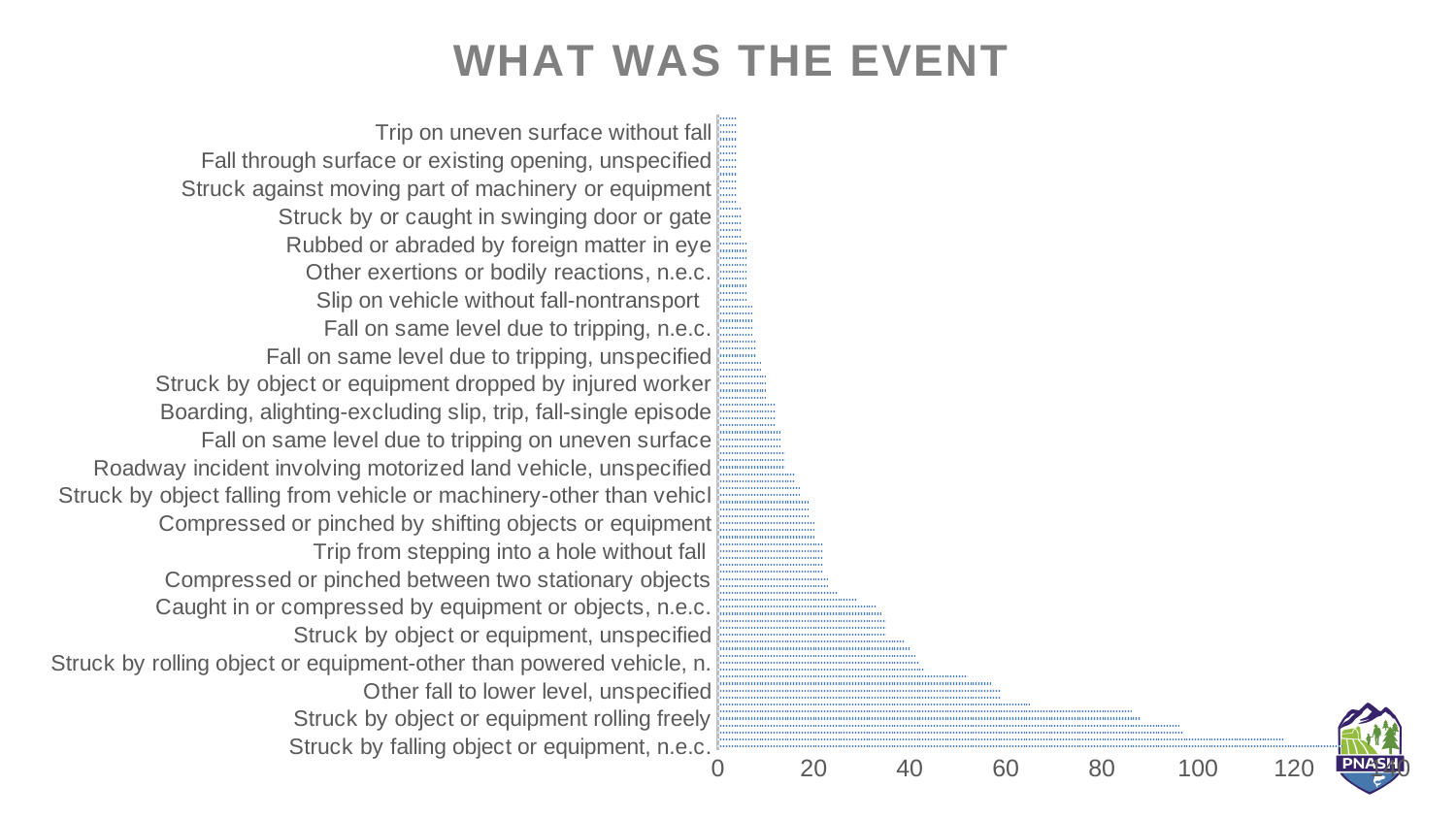
Which event category has the longest bar? Struck by falling object or equipment, n.e.c. Is the value for "Fall on same level due to tripping, unspecified" greater or less than 20? less Which is larger: the value for "Struck by falling object or equipment, n.e.c." or the value for "Other fall to lower level, unspecified"? Struck by falling object or equipment, n.e.c. What is the title of the chart? WHAT WAS THE EVENT Is the value for "Trip on uneven surface without fall" greater or less than 20? less Is the value for "Struck by object or equipment rolling freely" greater or less than 60? greater Do the bar lengths increase or decrease going from the top of the chart to the bottom? increase Which is larger: the value for "Struck by object or equipment rolling freely" or the value for "Trip from stepping into a hole without fall"? Struck by object or equipment rolling freely What kind of chart is shown on the slide? bar chart